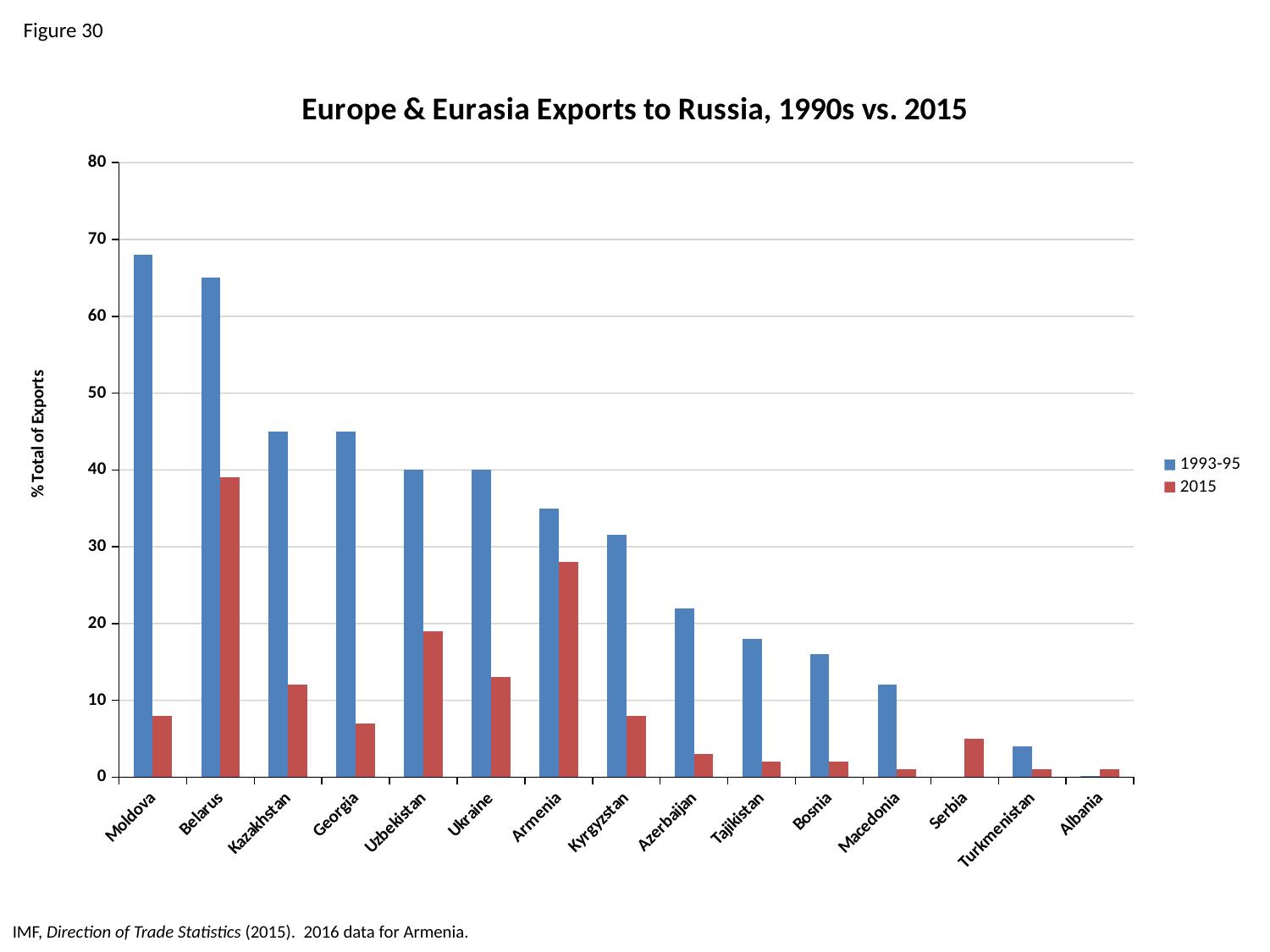
Which country has the highest 2015 value? Belarus How many countries are shown on the x axis? 15 Is the 2015 value for Armenia greater or less than 20? greater How many series does the legend list? 2 What is the title of the chart? Europe & Eurasia Exports to Russia, 1990s vs. 2015 Which is larger for Serbia: the 1993-95 value or the 2015 value? 2015 Which is larger for Ukraine: the 1993-95 value or the 2015 value? 1993-95 Is the 1993-95 value for Moldova greater or less than 60? greater Do the 1993-95 values generally rise or fall moving from left to right along the x axis? fall Is the 2015 value for Kazakhstan greater or less than 20? less What kind of chart is shown on the slide? bar chart Which country has the highest 1993-95 value? Moldova